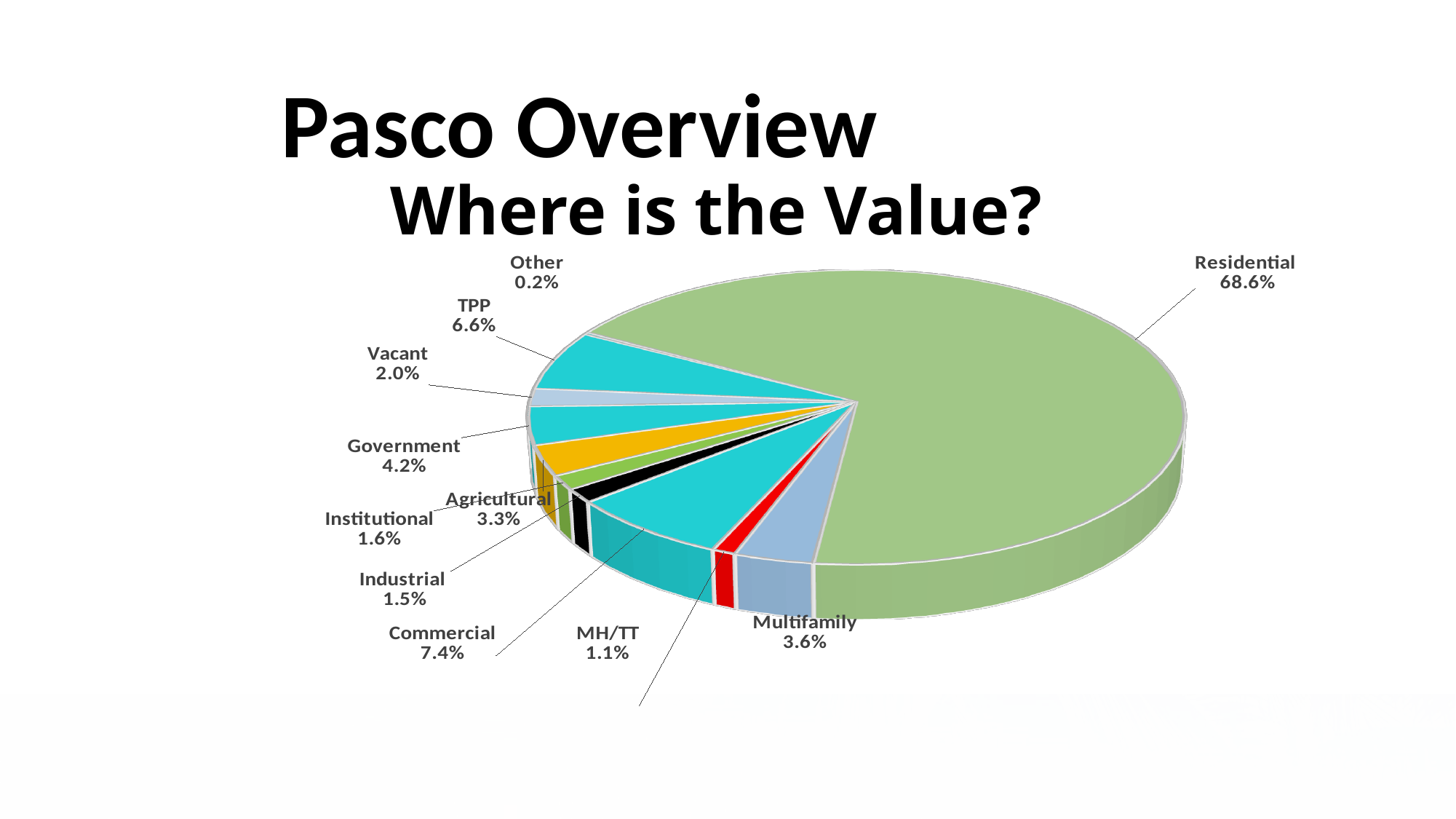
Which category has the smallest share of the pie? Other Which is larger, Commercial or TPP? Commercial What share of the pie does Residential hold? 68.6% What is the difference between the Multifamily and Agricultural shares? 0.3% What is the subtitle of the slide above the chart? Where is the Value? What is the value shown for Government? 4.2% Which category has the largest share of the pie? Residential What is the value shown for Commercial? 7.4% What is the value shown for TPP? 6.6% What is the value shown for MH/TT? 1.1% How many categories are shown in the pie chart? 11 What kind of chart is shown on the slide? pie chart